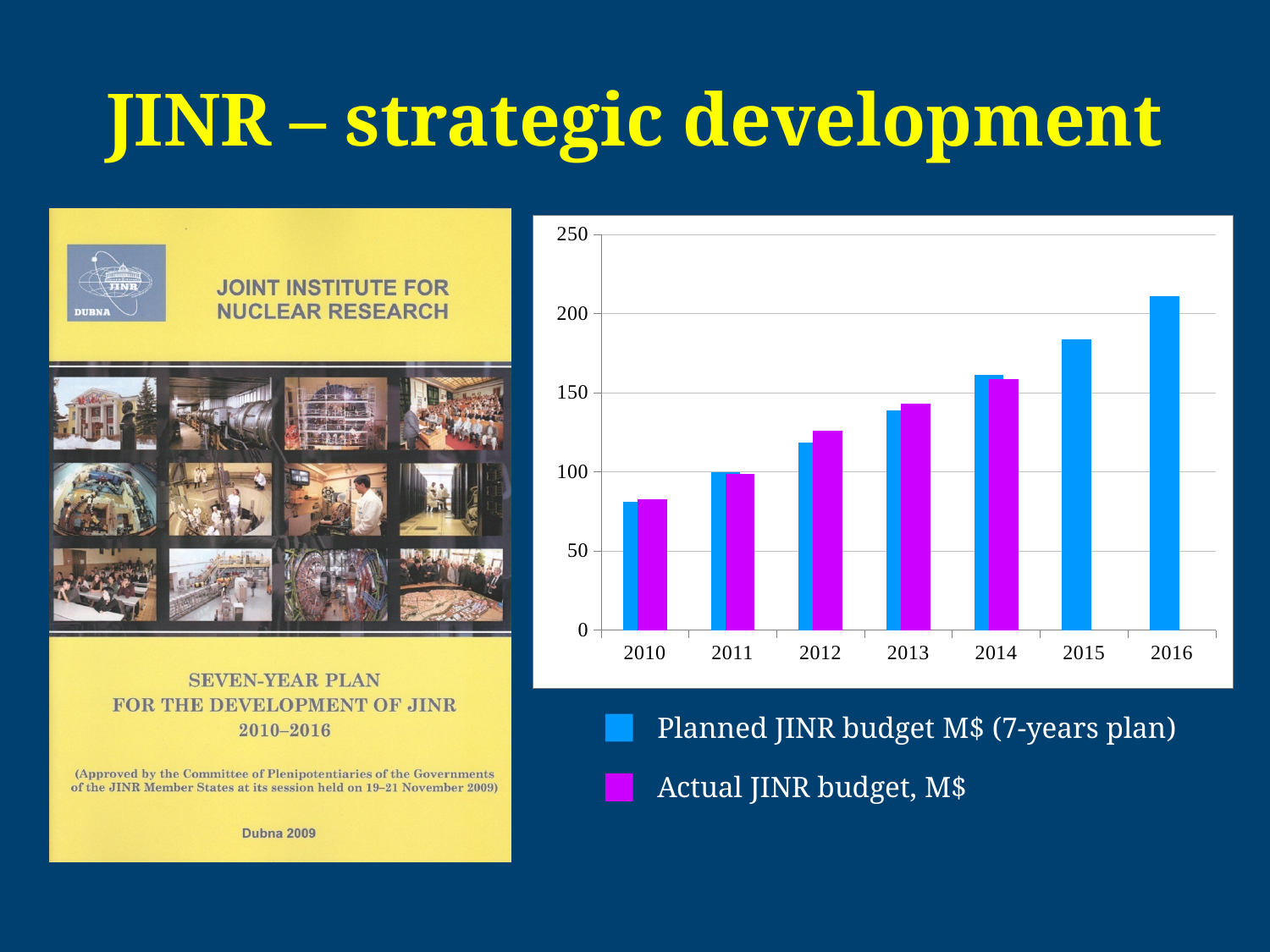
In 2012, which is larger: the planned JINR budget or the actual JINR budget? Actual JINR budget Which year has the highest planned JINR budget? 2016 Which colour represents the actual JINR budget in the chart? magenta How many series does the legend list? 2 For how many years is an actual JINR budget bar shown? 5 Is the actual JINR budget for 2010 greater or less than 100? less What kind of chart is shown on the slide? bar chart How many years are shown on the x axis of the chart? 7 Is the planned JINR budget for 2016 greater or less than 200? greater Is the planned JINR budget for 2015 greater or less than 150? greater Which year has the lowest planned JINR budget? 2010 Does the planned JINR budget rise or fall from 2010 to 2016? rise